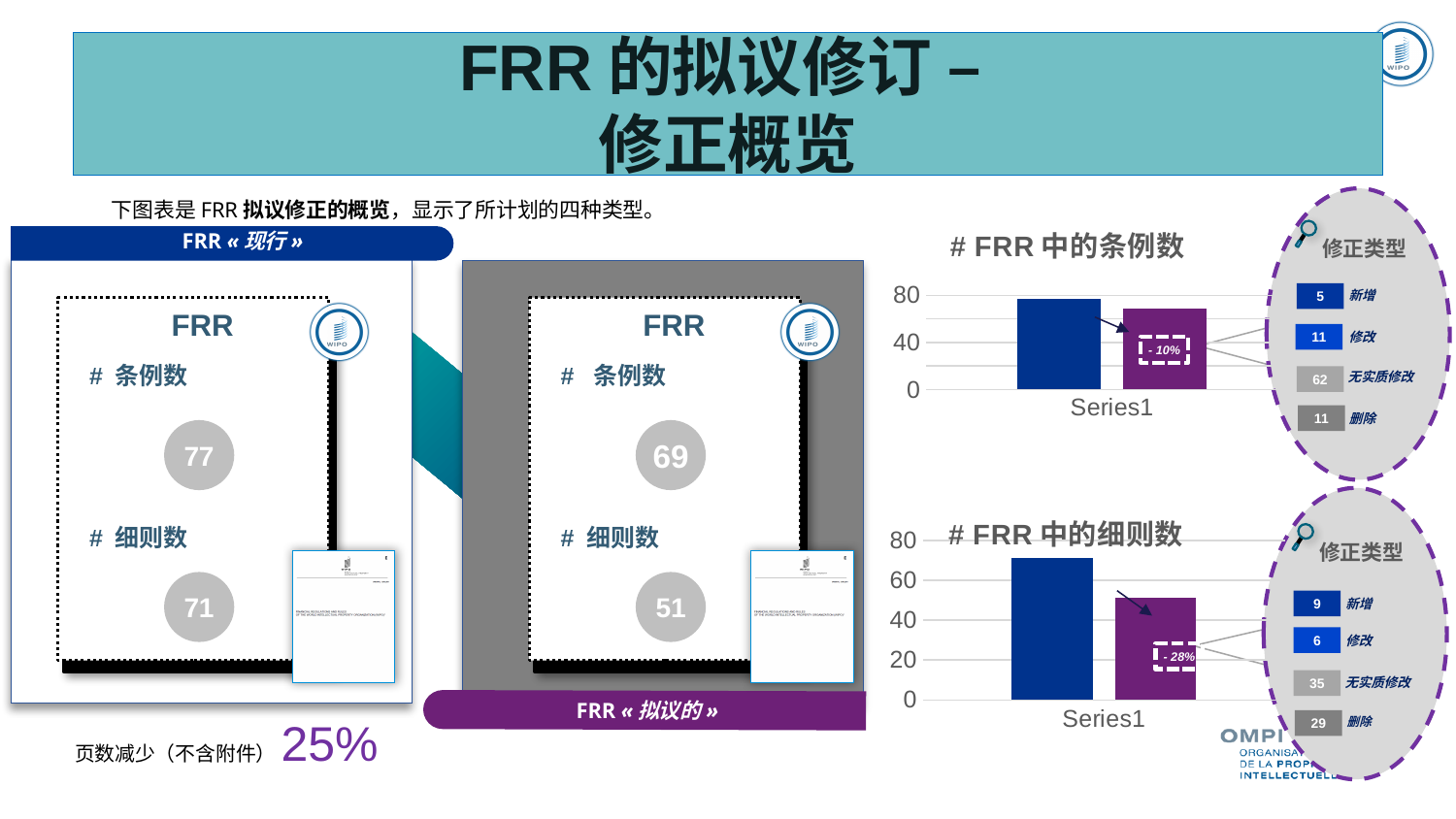
In the "# FRR 中的细则数" chart, is the blue bar greater or less than 60? greater In the "# FRR 中的细则数" chart, which bar is taller, the blue bar or the purple bar? the blue bar In the "# FRR 中的条例数" chart, is the purple bar greater or less than 80? less In the "# FRR 中的条例数" chart, which bar is taller, the blue bar or the purple bar? the blue bar What percentage change is annotated on the purple bar of the "# FRR 中的细则数" chart? -28% How many bars are plotted in the "# FRR 中的细则数" chart? 2 What kind of chart is the "# FRR 中的细则数" chart? bar chart In the "# FRR 中的条例数" chart, is the blue bar greater or less than 40? greater What kind of chart is the "# FRR 中的条例数" chart? bar chart What percentage change is annotated on the purple bar of the "# FRR 中的条例数" chart? -10% How many bars are plotted in the "# FRR 中的条例数" chart? 2